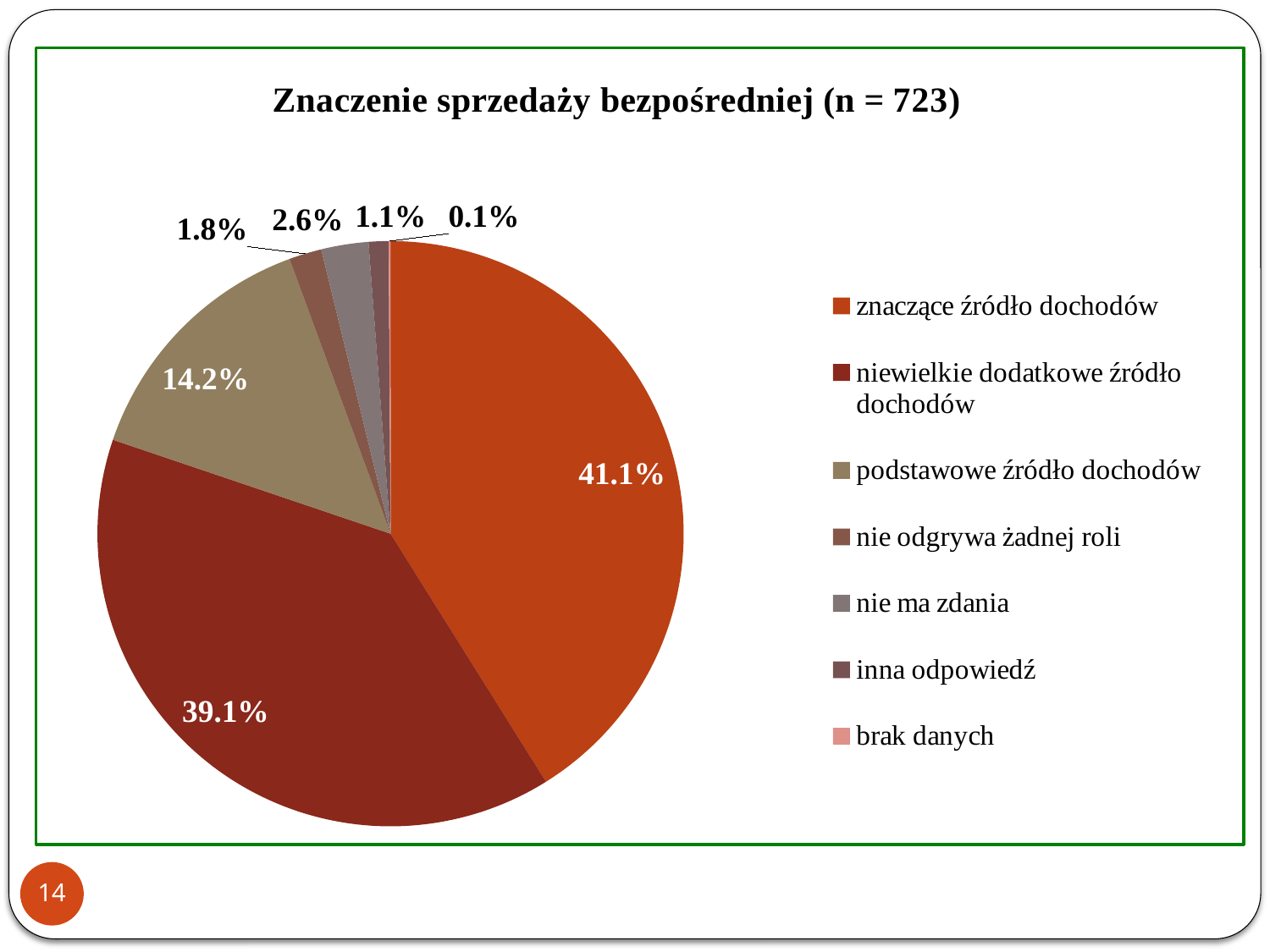
What share of the pie is labelled for "brak danych"? 0.1% What is the title of the chart? Znaczenie sprzedaży bezpośredniej (n = 723) Which category has the largest slice of the pie? znaczące źródło dochodów What share of the pie is labelled for "znaczące źródło dochodów"? 41.1% What share of the pie is labelled for "nie ma zdania"? 2.6% What share of the pie is labelled for "podstawowe źródło dochodów"? 14.2% Which category has the smallest slice of the pie? brak danych Which is larger, the share for "nie ma zdania" or the share for "nie odgrywa żadnej roli"? nie ma zdania How many categories does the legend list? 7 What is the difference between the shares for "znaczące źródło dochodów" and "niewielkie dodatkowe źródło dochodów"? 2.0% What kind of chart is shown on the slide? pie chart What share of the pie is labelled for "niewielkie dodatkowe źródło dochodów"? 39.1%